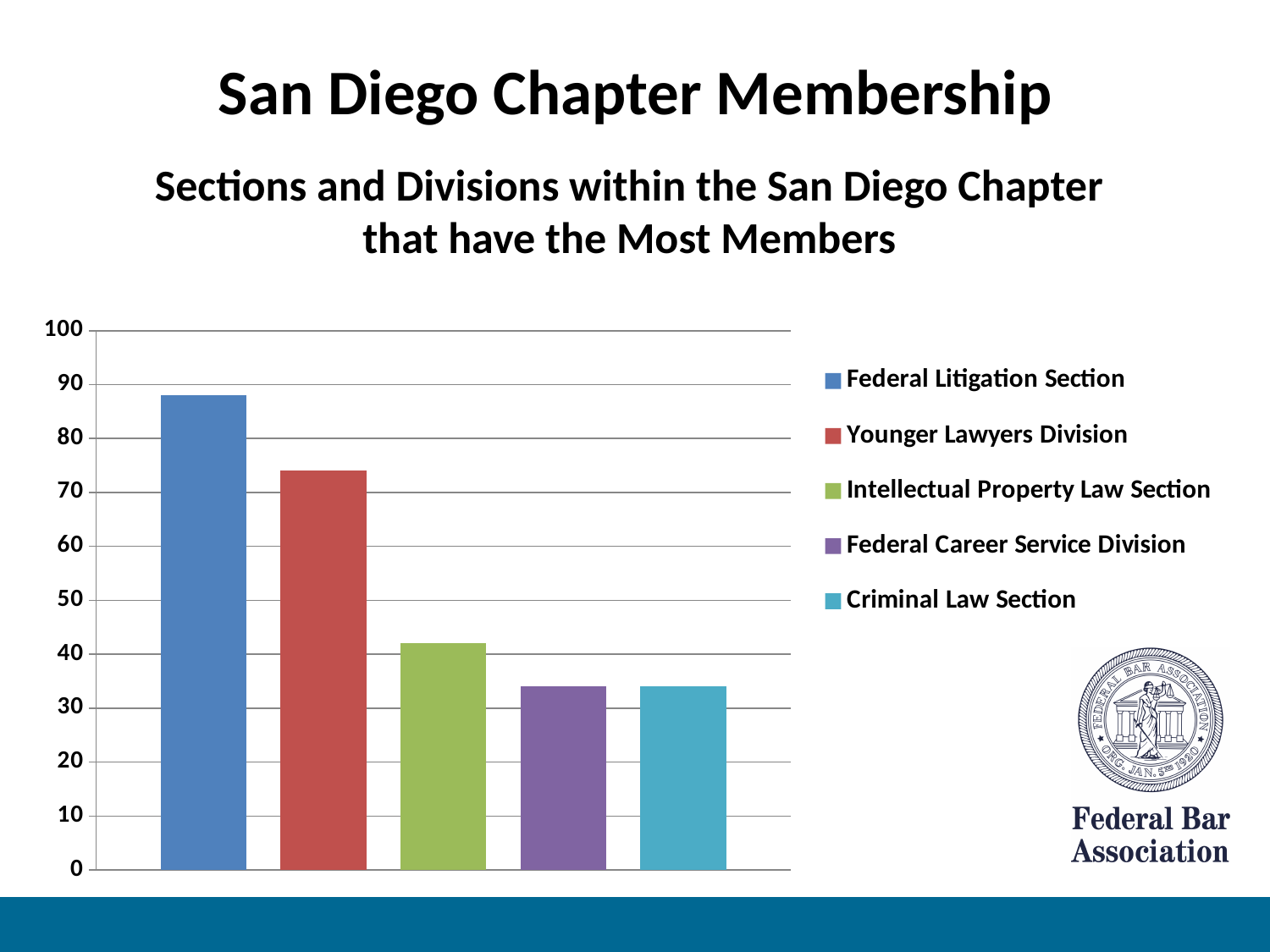
Which has more members, the Federal Litigation Section or the Younger Lawyers Division? Federal Litigation Section Do the bar values rise or fall from left to right across the chart? fall Is the value for the Intellectual Property Law Section greater or less than 50? less Is the value for the Younger Lawyers Division greater or less than 70? greater Is the value for the Federal Career Service Division greater or less than 40? less What kind of chart is shown on the slide? bar chart What is the title of the chart? Sections and Divisions within the San Diego Chapter that have the Most Members Which section or division has the highest number of members? Federal Litigation Section Which has more members, the Younger Lawyers Division or the Intellectual Property Law Section? Younger Lawyers Division How many entries does the legend list? 5 How many bars are plotted in the chart? 5